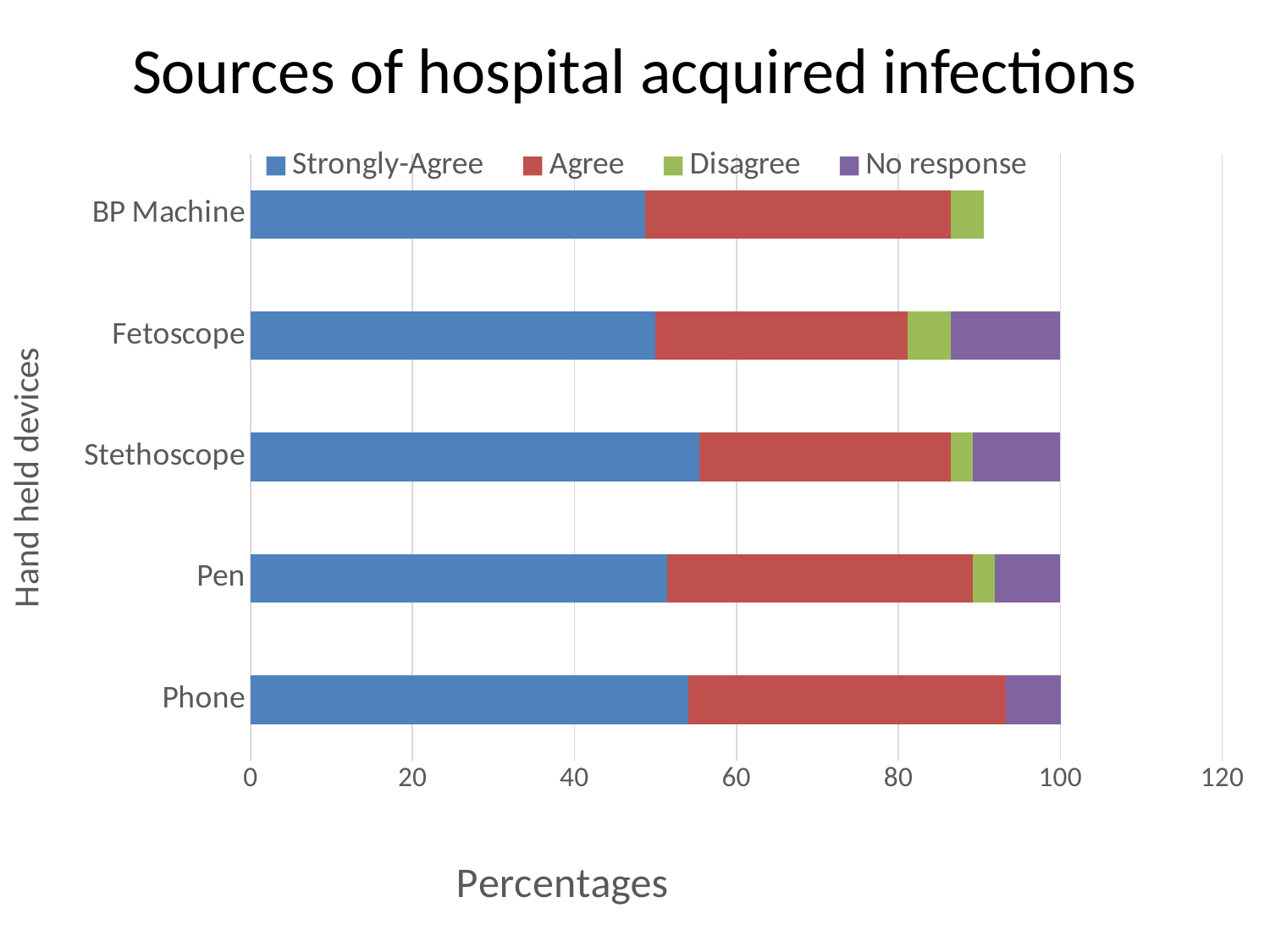
What is the title of the chart? Sources of hospital acquired infections Which device has no No response segment at all? BP Machine How many hand held devices are listed on the vertical axis? 5 What kind of chart is shown on the slide? Stacked bar chart Which is larger, the Agree segment for Phone or the Agree segment for Fetoscope? Phone Which is larger, the No response segment for Fetoscope or the No response segment for Phone? Fetoscope Is the Strongly-Agree value for Stethoscope greater or less than 40? greater Which device has the largest No response segment? Fetoscope What is the label of the horizontal axis? Percentages Is the Strongly-Agree value for Phone greater or less than 60? less How many series does the legend list? 4 Is the total length of the BP Machine bar greater or less than 100? less